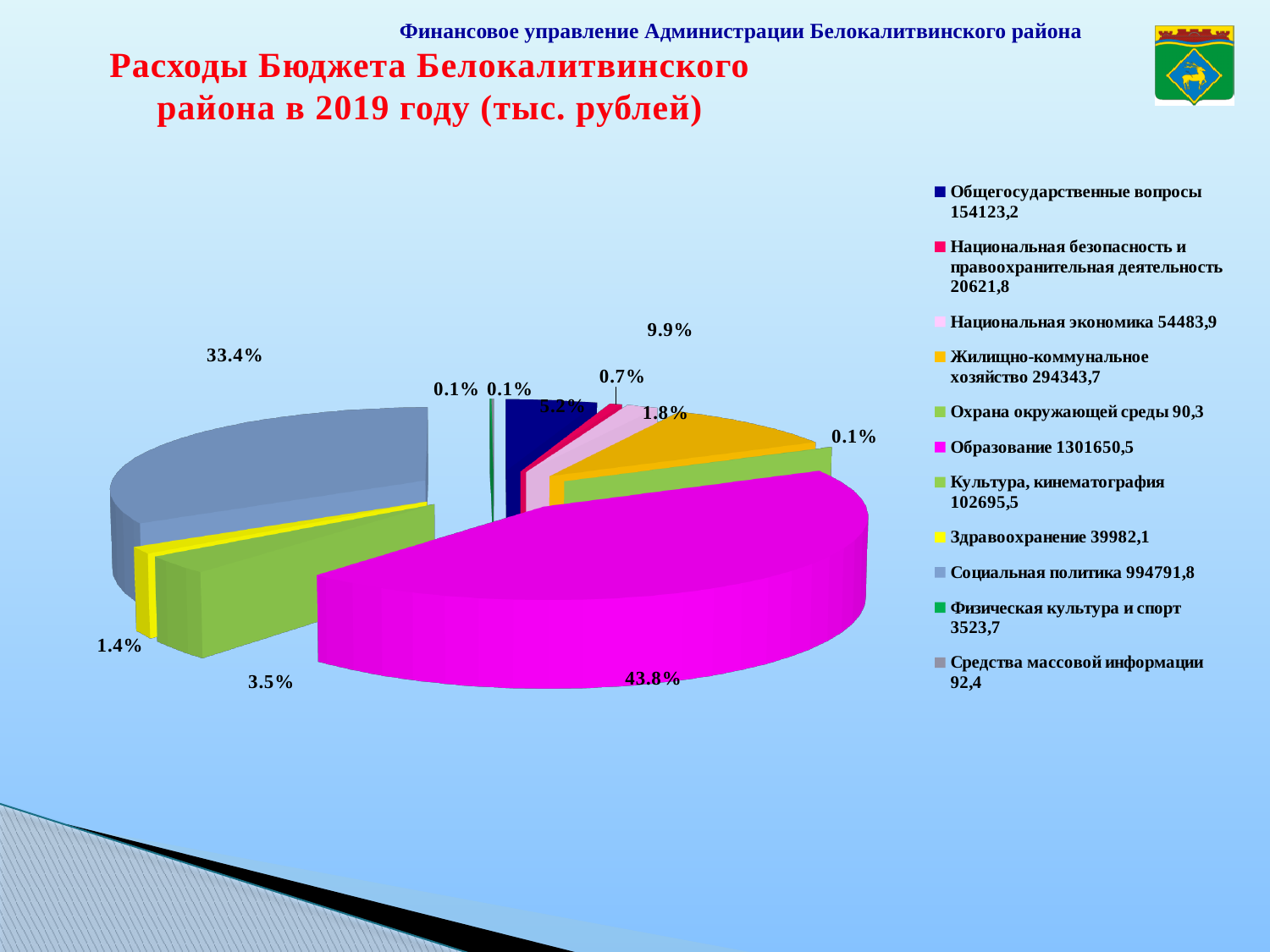
Which category has the largest expenditure in the pie chart? Образование Which is larger, the value for Общегосударственные вопросы or the value for Культура, кинематография? Общегосударственные вопросы What is the value shown for Социальная политика? 994791,8 What is the value shown for Жилищно-коммунальное хозяйство? 294343,7 What is the value shown for Физическая культура и спорт? 3523,7 What kind of chart is shown on the slide? Pie chart What share of the pie does Социальная политика take? 33.4% How many categories does the legend of the pie chart list? 11 What is the title of the chart on the slide? Расходы Бюджета Белокалитвинского района в 2019 году (тыс. рублей) What share of the pie does Образование take? 43.8% Which category has the smallest expenditure according to the legend values? Охрана окружающей среды What is the difference between the values for Общегосударственные вопросы and Культура, кинематография? 51427,7